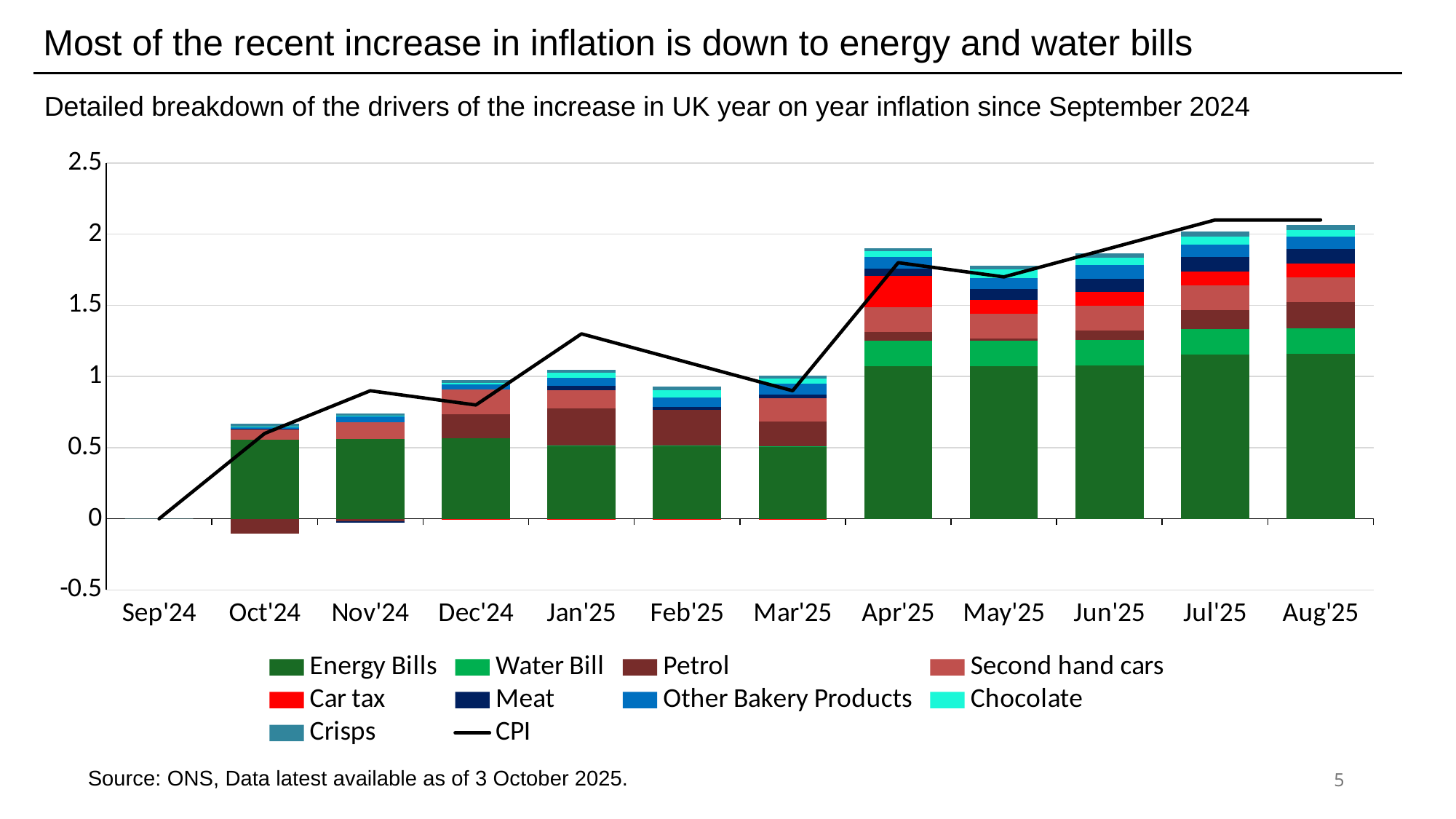
Is the CPI value for Mar'25 greater or less than 1? less How many series does the legend list? 10 What is the CPI value for Sep'24? 0 Does the CPI line generally rise or fall from Sep'24 to Aug'25? Rise Is the Energy Bills contribution for Apr'25 greater or less than 1? greater What kind of chart is shown on the slide? A stacked bar chart with a line Which series is the largest contributor in the Aug'25 bar? Energy Bills Which month has the lowest CPI value? Sep'24 Is the CPI value higher in Apr'25 or in Mar'25? Apr'25 What is the title of the slide? Most of the recent increase in inflation is down to energy and water bills How many months are shown along the x axis? 12 Is the CPI value for Aug'25 greater or less than 2? greater